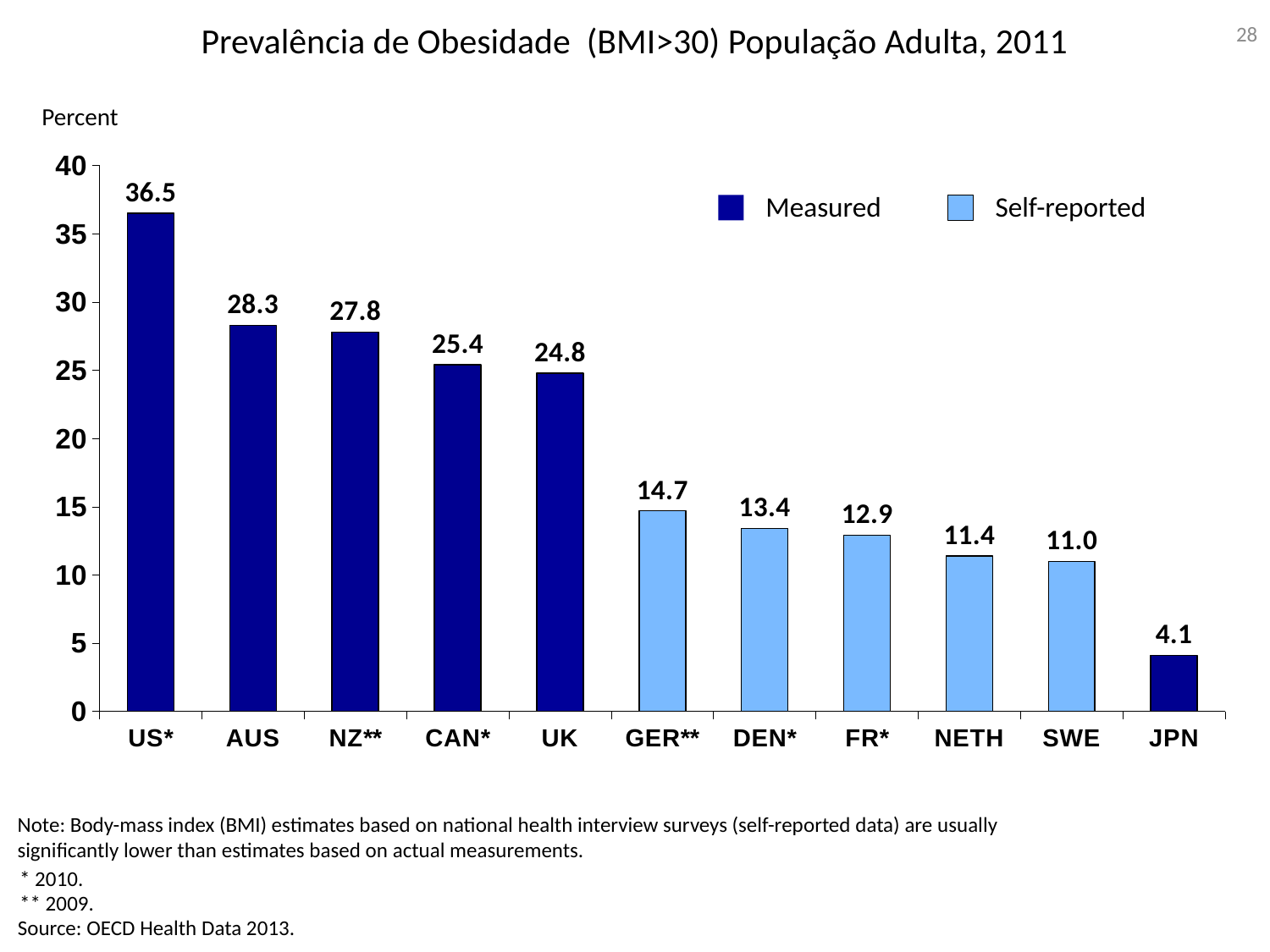
How many series does the legend list? 2 What is the difference between the values for US* and AUS? 8.2 What is the obesity prevalence value shown for US*? 36.5 Which has a higher value, CAN* or UK? CAN* What is the value shown for GER**? 14.7 How many countries are shown on the x axis? 11 Which country has the lowest obesity prevalence on the chart? JPN What kind of chart is shown on the slide? Bar chart What is the difference between the values for GER** and DEN*? 1.3 Which legend series does the bar for SWE belong to? Self-reported What is the value shown for JPN? 4.1 Which country has the highest obesity prevalence on the chart? US*